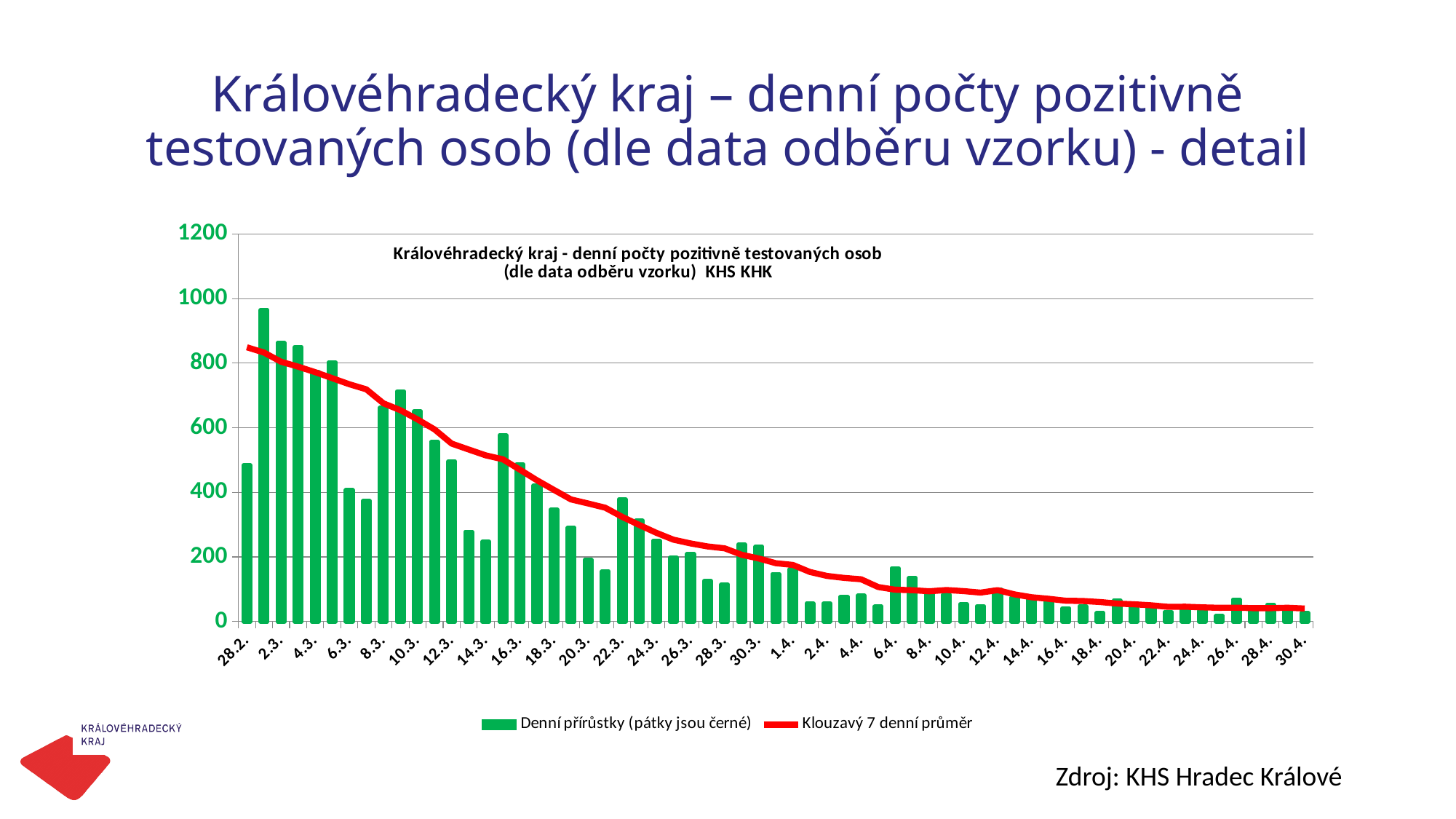
Is the daily value (Denní přírůstky) for 1.4. greater or less than 200? less Is the 7-day moving average (Klouzavý 7 denní průměr) at 28.2. greater or less than 800? greater How many series does the legend list? 2 Is the daily value (Denní přírůstky) for 30.4. greater or less than 200? less What kind of chart is shown on the slide? bar chart with a line Which is larger, the daily value for 2.3. or the daily value for 30.4.? 2.3. What are the two legend entries of the chart? Denní přírůstky (pátky jsou černé); Klouzavý 7 denní průměr Do the daily values generally rise or fall from 28.2. to 30.4.? fall What colour is the 'Klouzavý 7 denní průměr' line? red